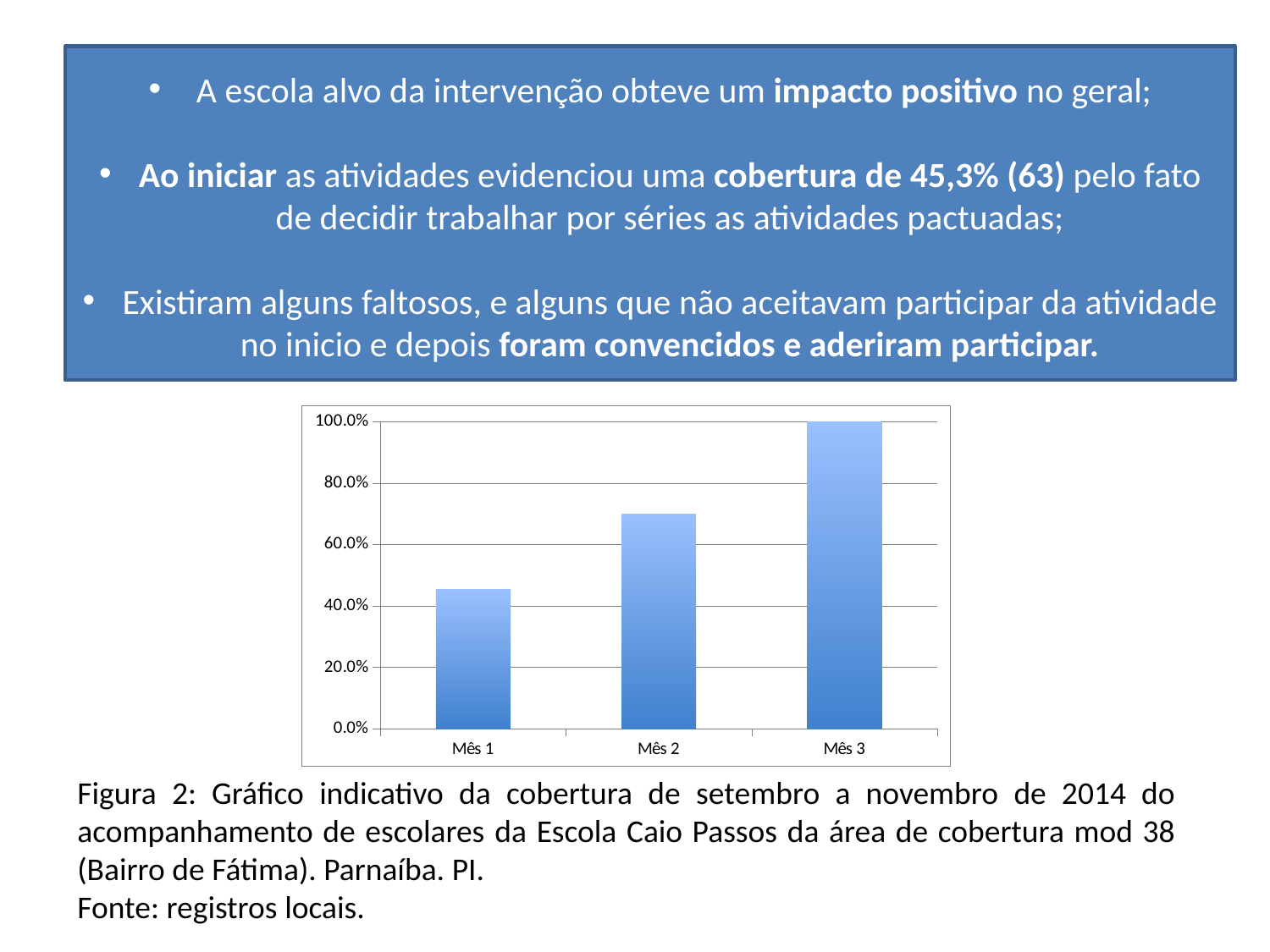
Which month has the lowest bar in the chart? Mês 1 Is the value for Mês 2 greater or less than 80.0%? less Is the value for Mês 2 greater or less than 60.0%? greater Do the values rise or fall from Mês 1 to Mês 3? rise How many categories are plotted on the x axis of the chart? 3 What kind of chart is shown on the slide? bar chart Is the value for Mês 1 greater or less than 60.0%? less Which month has the highest bar in the chart? Mês 3 Which is larger, the value for Mês 1 or the value for Mês 2? Mês 2 What is the highest tick label shown on the y axis of the chart? 100.0% What is the value shown for Mês 3? 100.0%